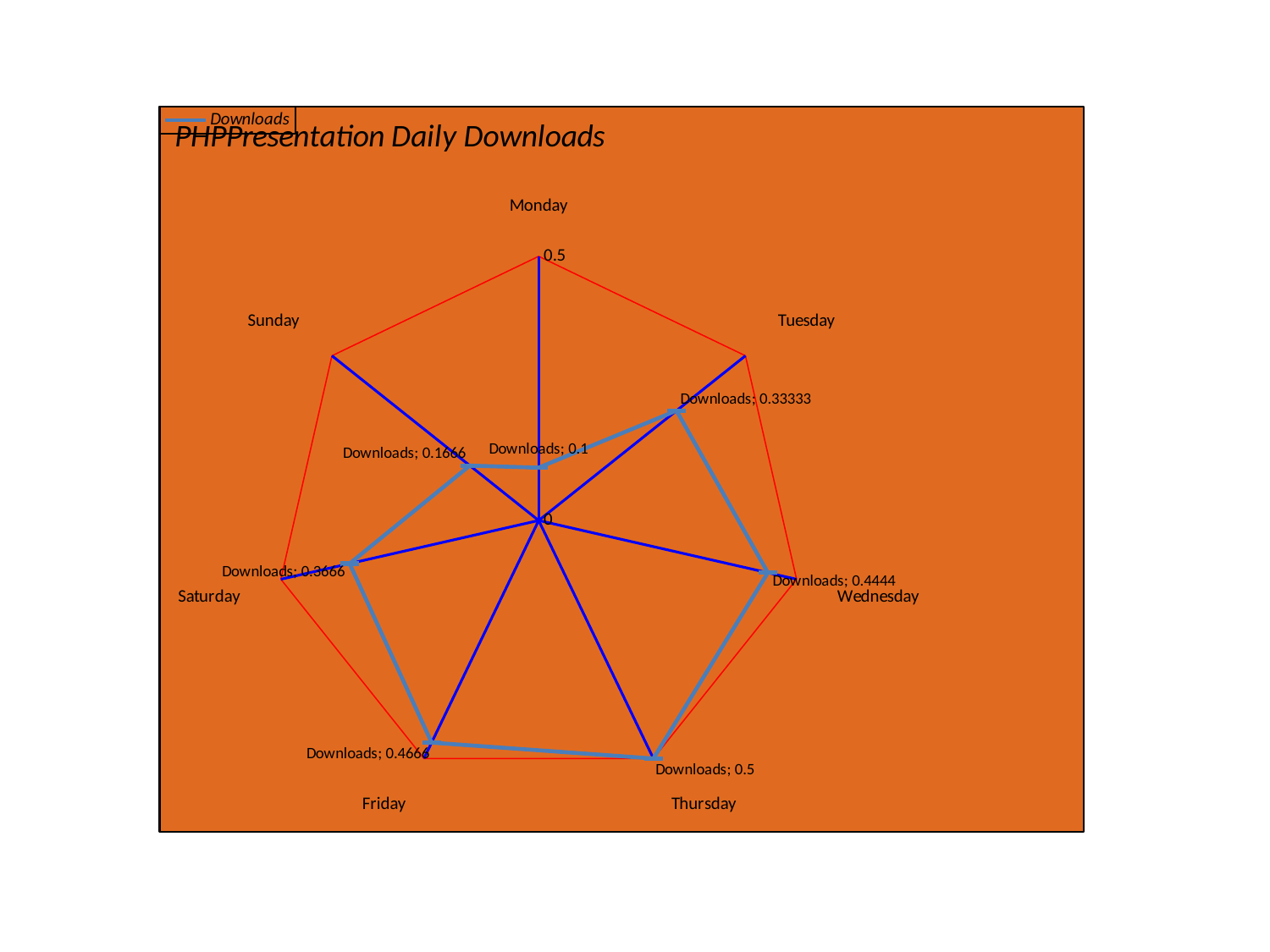
Which day has the highest Downloads value? Thursday How many series does the legend list? 1 Which has the larger Downloads value, Friday or Saturday? Friday What is the difference between the Downloads values for Thursday and Monday? 0.4 What is the Downloads value for Thursday? 0.5 What is the title of the chart? PHPPresentation Daily Downloads What is the Downloads value for Wednesday? 0.4444 What kind of chart is shown on the slide? Radar chart Which day has the lowest Downloads value? Monday What is the Downloads value for Tuesday? 0.33333 How many days (categories) are plotted on the chart? 7 What is the Downloads value for Sunday? 0.1666